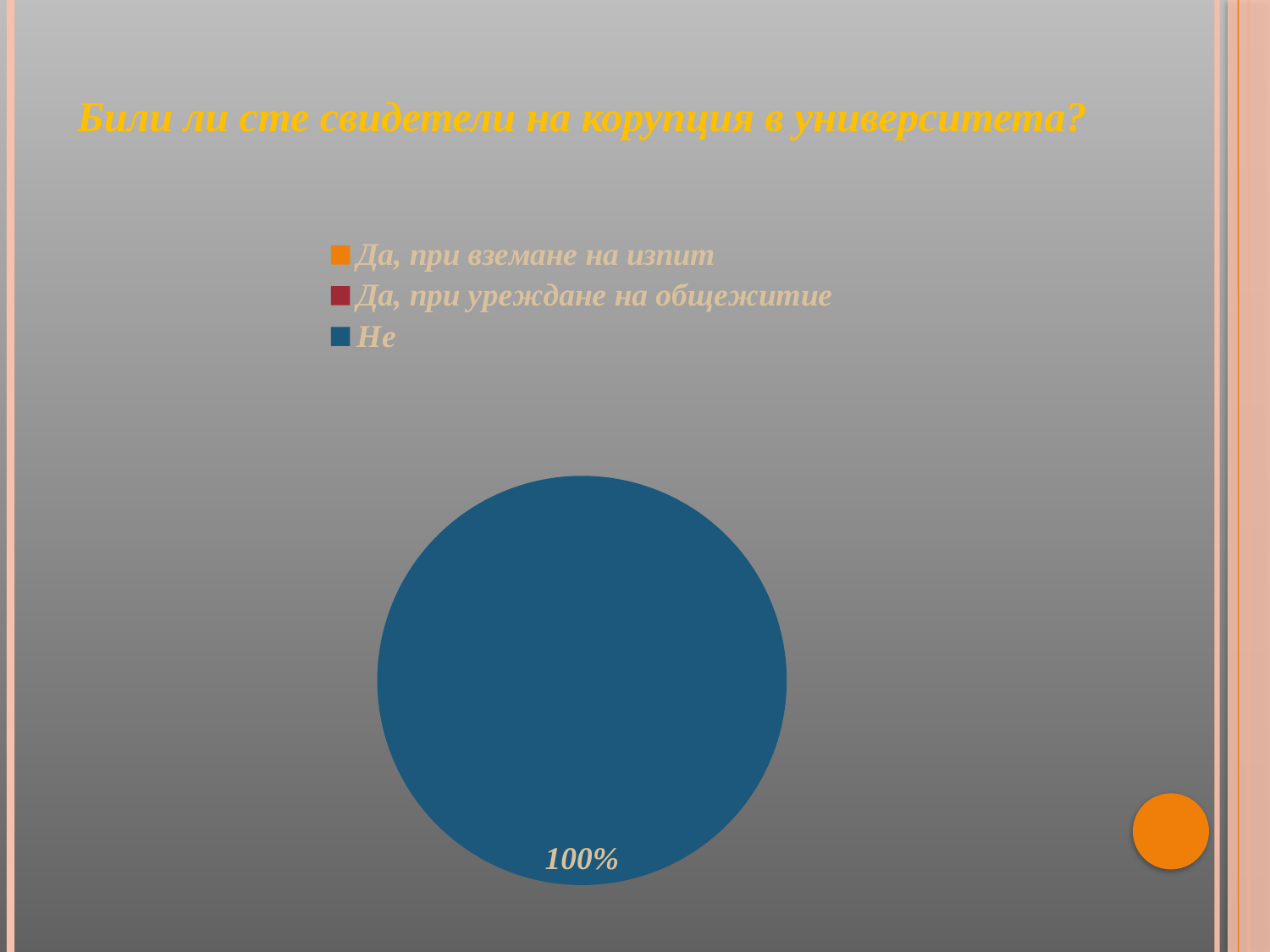
What kind of chart is shown on the slide? pie chart What value is printed on the pie chart? 100% What is the title of the chart? Били ли сте свидетели на корупция в университета? What colour is the "Не" slice in the pie chart? blue What share of the pie does the "Не" slice take? 100% How many entries does the legend list? 3 How many slices are visible in the pie chart? 1 Which category has the largest share of the pie? Не